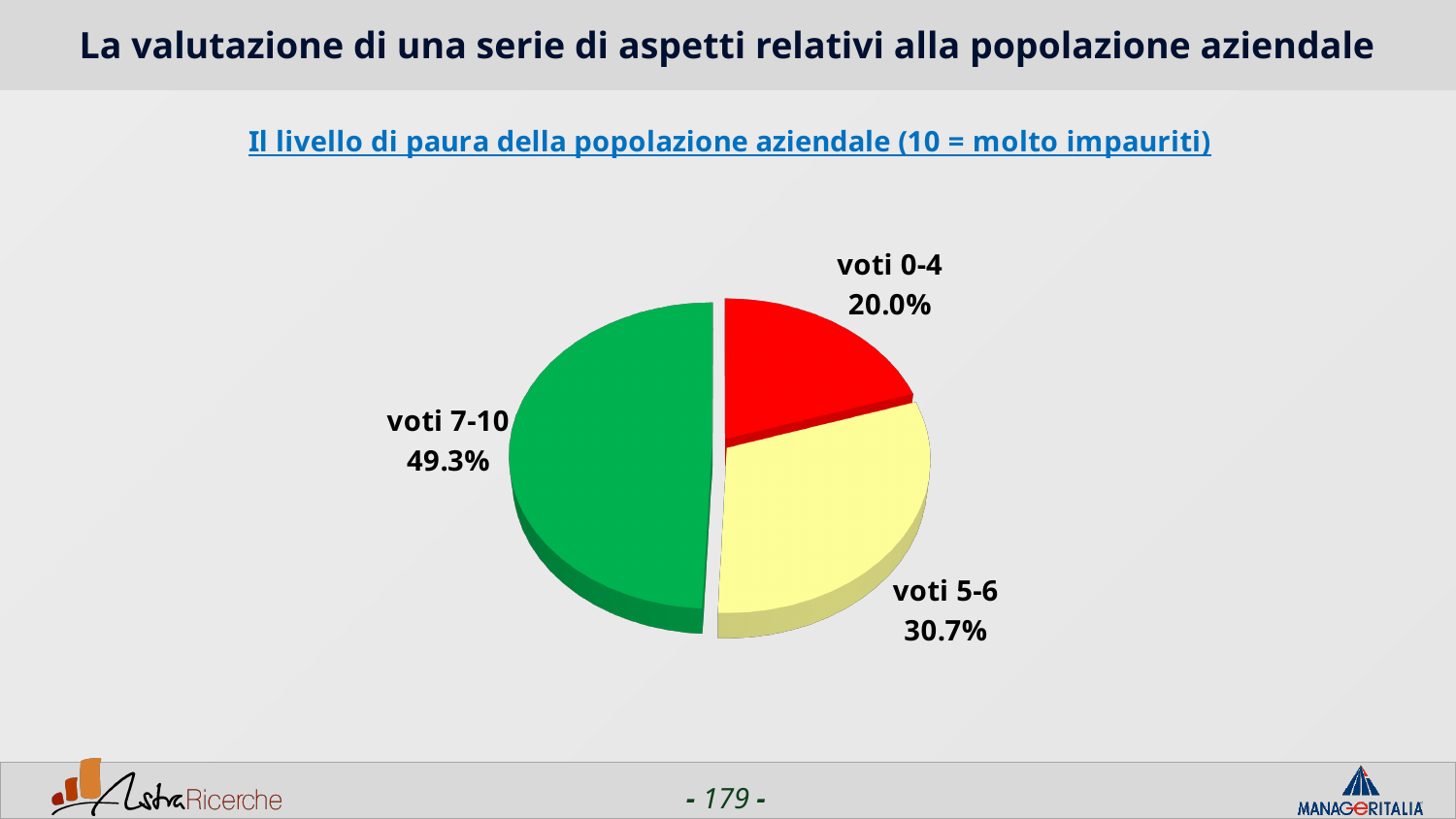
What colour is the slice for 'voti 0-4'? red What kind of chart is shown on the slide? pie chart What is the title of the chart? Il livello di paura della popolazione aziendale (10 = molto impauriti) How many slices does the pie chart have? 3 What is the difference between the shares of 'voti 7-10' and 'voti 5-6'? 18.6% What is the value shown for 'voti 5-6'? 30.7% What share of the pie does 'voti 7-10' represent? 49.3% Which category has the largest slice of the pie? voti 7-10 What is the value shown for 'voti 0-4'? 20.0% What is the difference between the shares of 'voti 5-6' and 'voti 0-4'? 10.7% Which is larger, the share for 'voti 5-6' or the share for 'voti 0-4'? voti 5-6 Which category has the smallest slice of the pie? voti 0-4